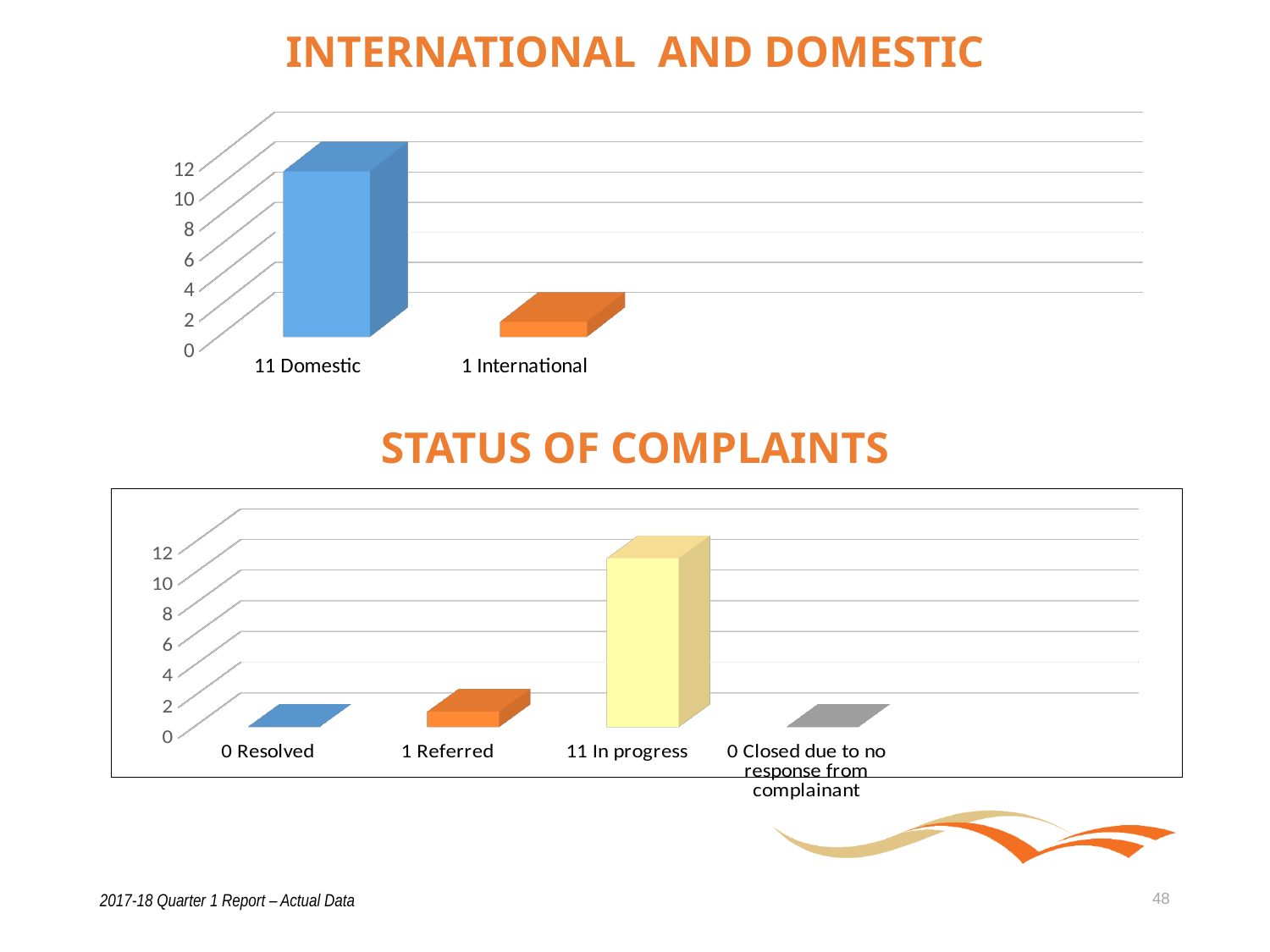
In the 'INTERNATIONAL AND DOMESTIC' chart, what is the difference between the Domestic and International values? 10 In the 'INTERNATIONAL AND DOMESTIC' chart, how many categories are shown? 2 In the 'STATUS OF COMPLAINTS' chart, is the value for In progress greater or less than 10? greater In the 'STATUS OF COMPLAINTS' chart, how many categories are shown? 4 In the 'INTERNATIONAL AND DOMESTIC' chart, which category has the highest value? Domestic In the 'STATUS OF COMPLAINTS' chart, which category has the highest value? In progress In the 'STATUS OF COMPLAINTS' chart, what is the value for Resolved? 0 What kind of chart is the 'STATUS OF COMPLAINTS' chart? Bar chart In the 'INTERNATIONAL AND DOMESTIC' chart, what is the value for Domestic? 11 In the 'STATUS OF COMPLAINTS' chart, what is the value for Referred? 1 In the 'STATUS OF COMPLAINTS' chart, what is the value for In progress? 11 In the 'INTERNATIONAL AND DOMESTIC' chart, what is the value for International? 1